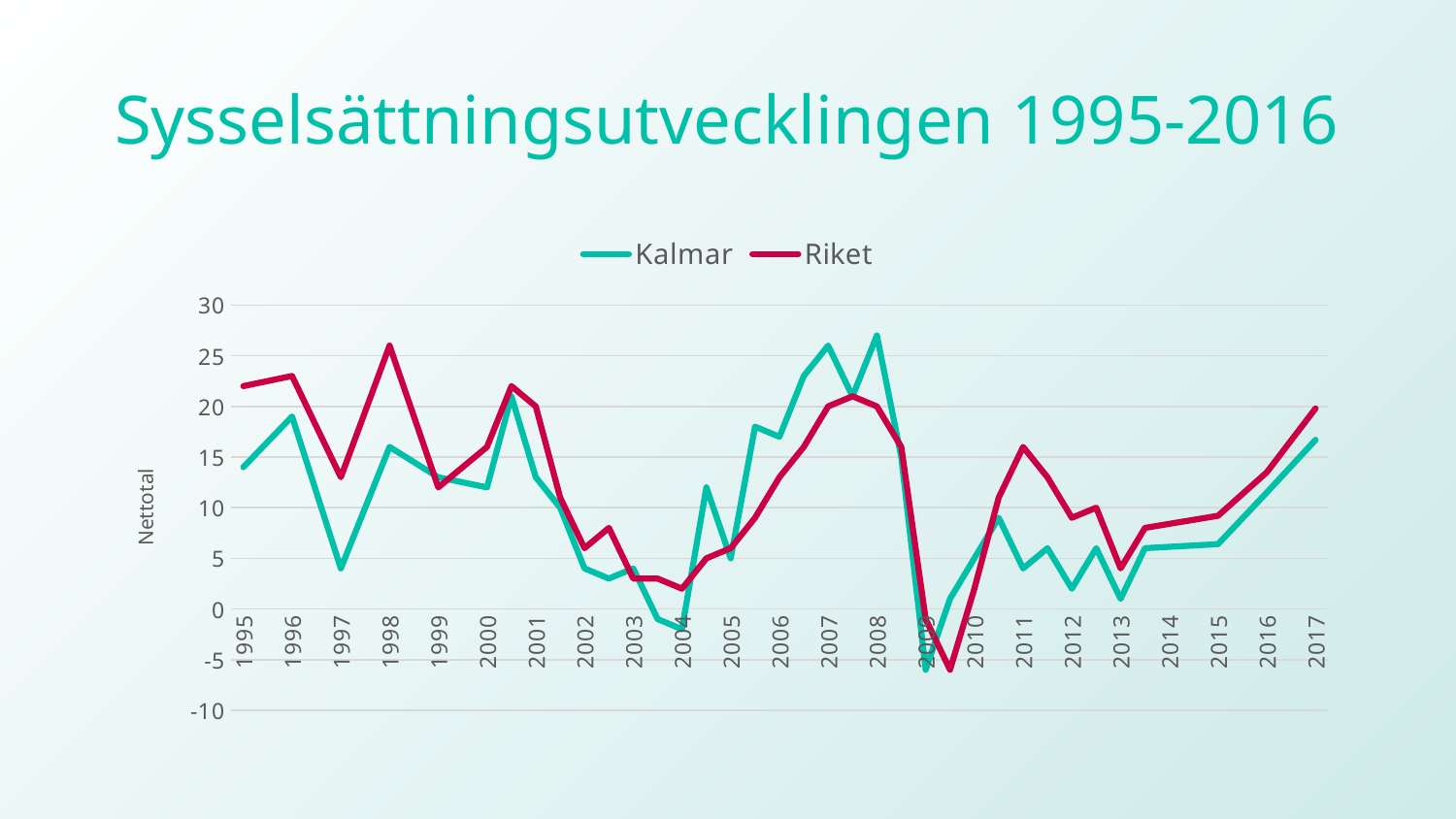
How many series does the legend list? 2 Is the value for Kalmar in 1997 greater or less than 10? less In 1995, which series has the higher value, Kalmar or Riket? Riket Is the value for Riket in 2009 greater or less than 0? less Is the value for Riket in 1998 greater or less than 20? greater Does the Kalmar line rise or fall between 2013 and 2017? rise In 2008, which series has the higher value, Kalmar or Riket? Kalmar What kind of chart is shown on the slide? line chart In 2011, which series has the higher value, Kalmar or Riket? Riket What are the two series named in the legend? Kalmar and Riket What is the label on the vertical axis? Nettotal